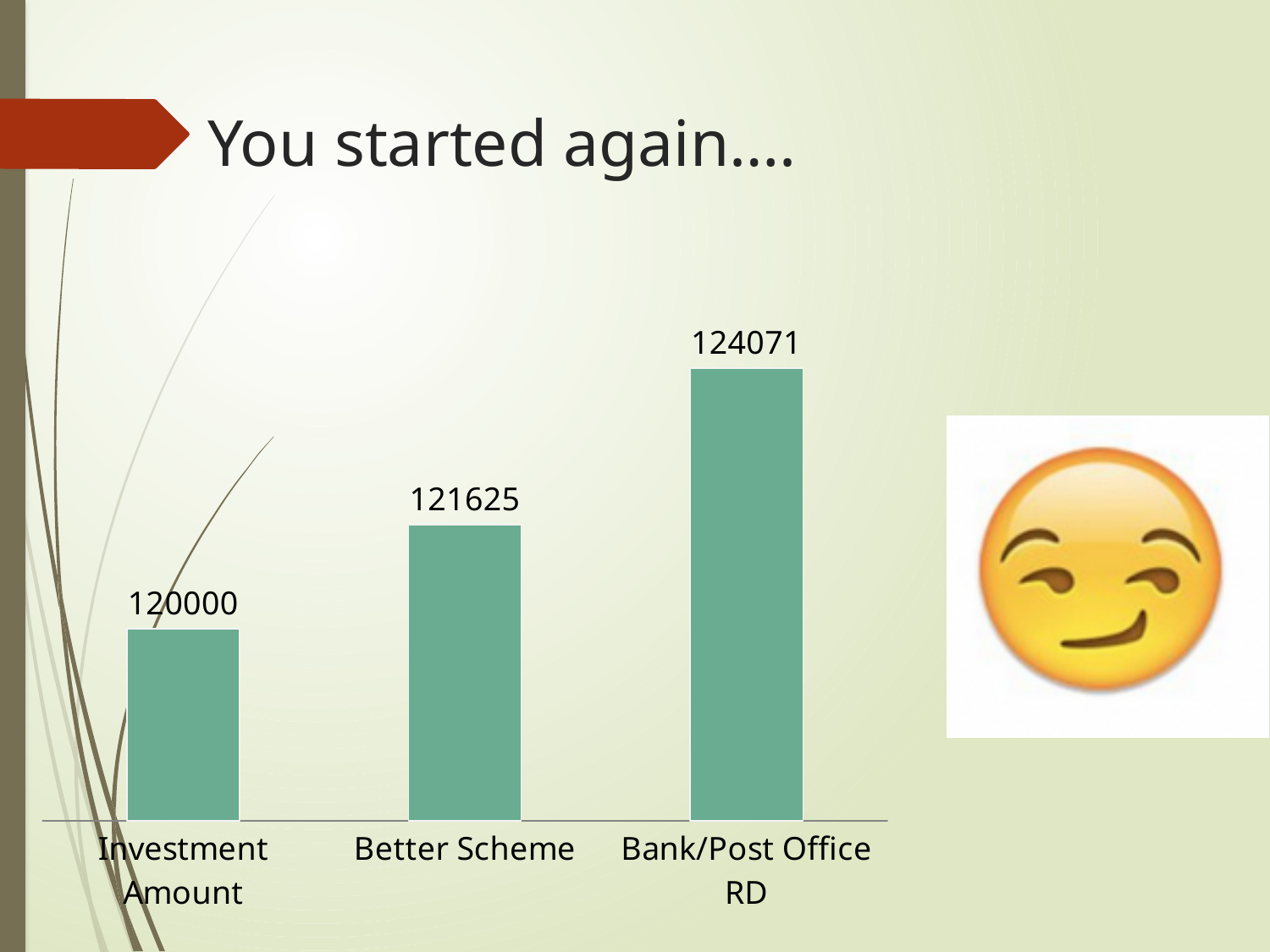
What is the value for Better Scheme? 121625 Do the values rise or fall from left to right across the categories? Rise What is the value for Investment Amount? 120000 Which category has the lowest value? Investment Amount What is the difference between the values for Bank/Post Office RD and Better Scheme? 2446 How many categories are shown in the chart? 3 What is the difference between the values for Better Scheme and Investment Amount? 1625 What is the difference between the values for Bank/Post Office RD and Investment Amount? 4071 Which is larger, the value for Better Scheme or the value for Investment Amount? Better Scheme What is the value for Bank/Post Office RD? 124071 Which category has the highest value? Bank/Post Office RD What kind of chart is shown on the slide? Bar chart